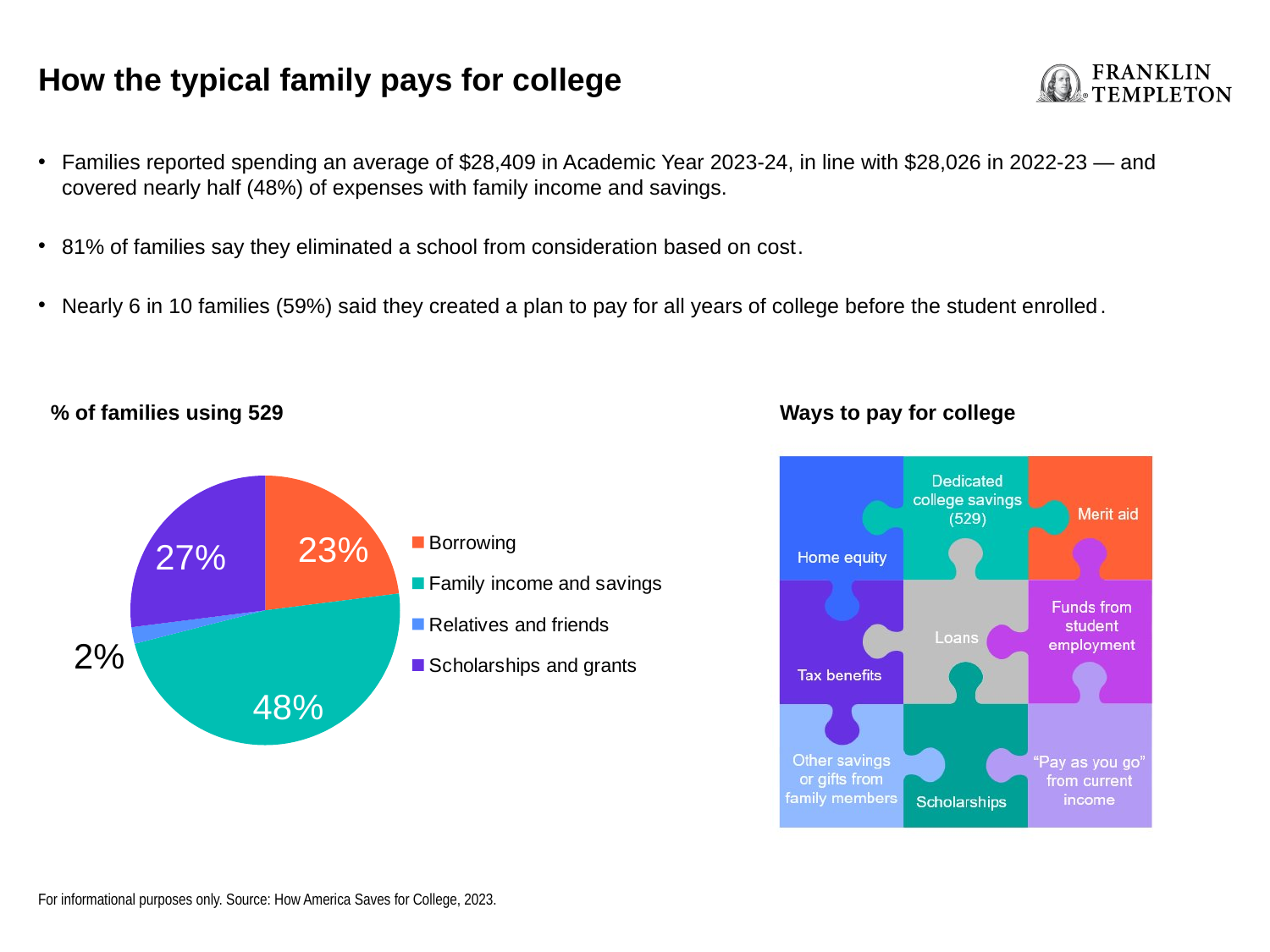
How many slices does the pie chart have? 4 In the pie chart, what share is labelled for Relatives and friends? 2% In the pie chart, what share is labelled for Borrowing? 23% Which slice of the pie chart is the smallest? Relatives and friends What kind of chart is shown under the heading '% of families using 529'? Pie chart Which slice of the pie chart is the largest? Family income and savings In the pie chart, what share is labelled for Family income and savings? 48% In the pie chart, which is larger: Scholarships and grants or Borrowing? Scholarships and grants In the pie chart, what share is labelled for Scholarships and grants? 27% How many entries does the pie chart's legend list? 4 What colour is the Family income and savings slice in the pie chart? Teal In the pie chart, what is the difference between the Family income and savings share and the Borrowing share? 25%